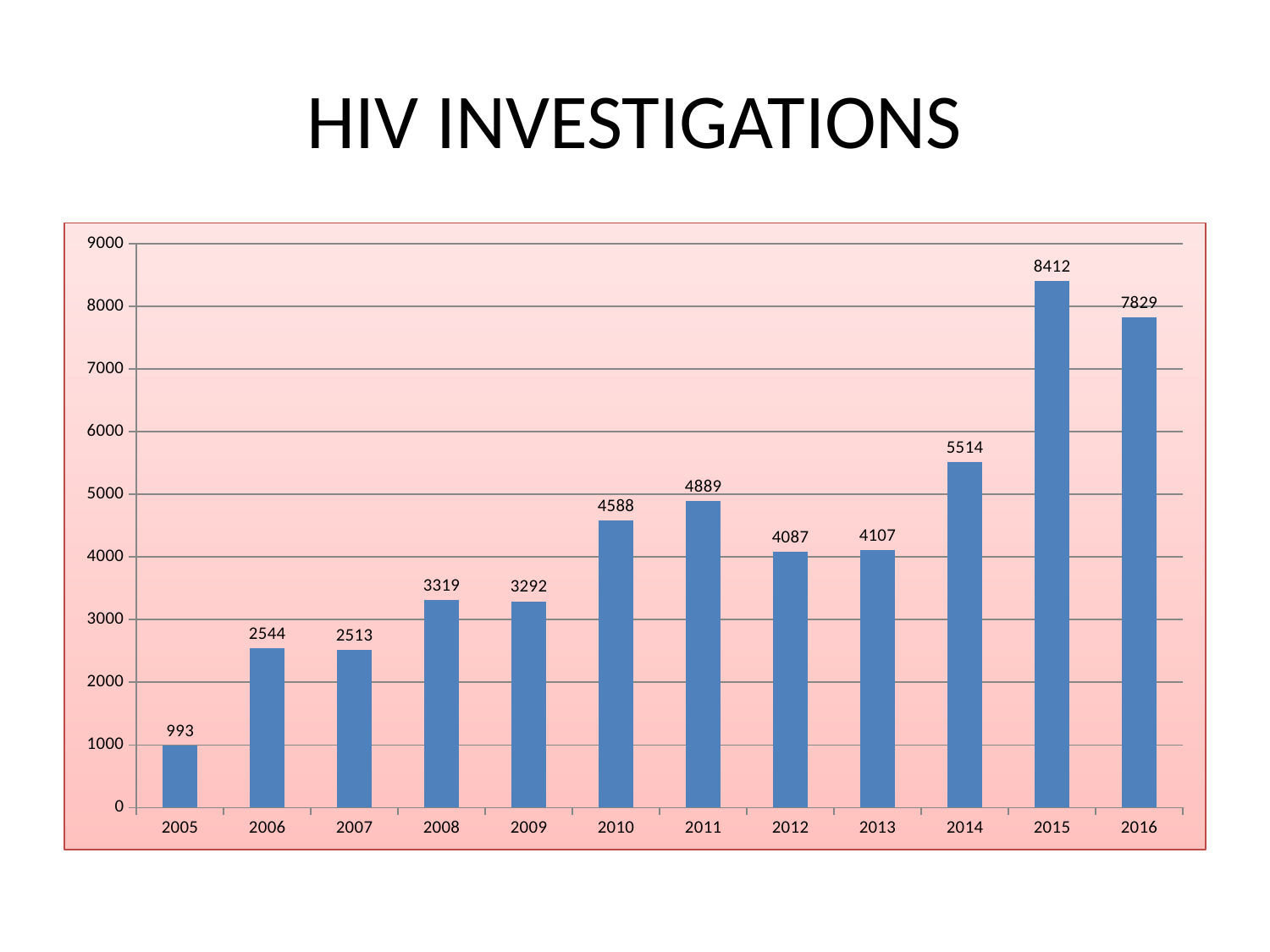
What is the difference between the values for 2008 and 2009? 27 What is the title of the slide? HIV INVESTIGATIONS What is the value for 2005? 993 Which year has the highest value? 2015 What is the value for 2010? 4588 Which is larger, the value for 2011 or the value for 2012? 2011 What is the difference between the values for 2015 and 2016? 583 What is the value for 2014? 5514 Which year has the lowest value? 2005 Is the value for 2014 greater or less than 5000? greater How many years are shown on the x axis? 12 What kind of chart is shown on the slide? bar chart